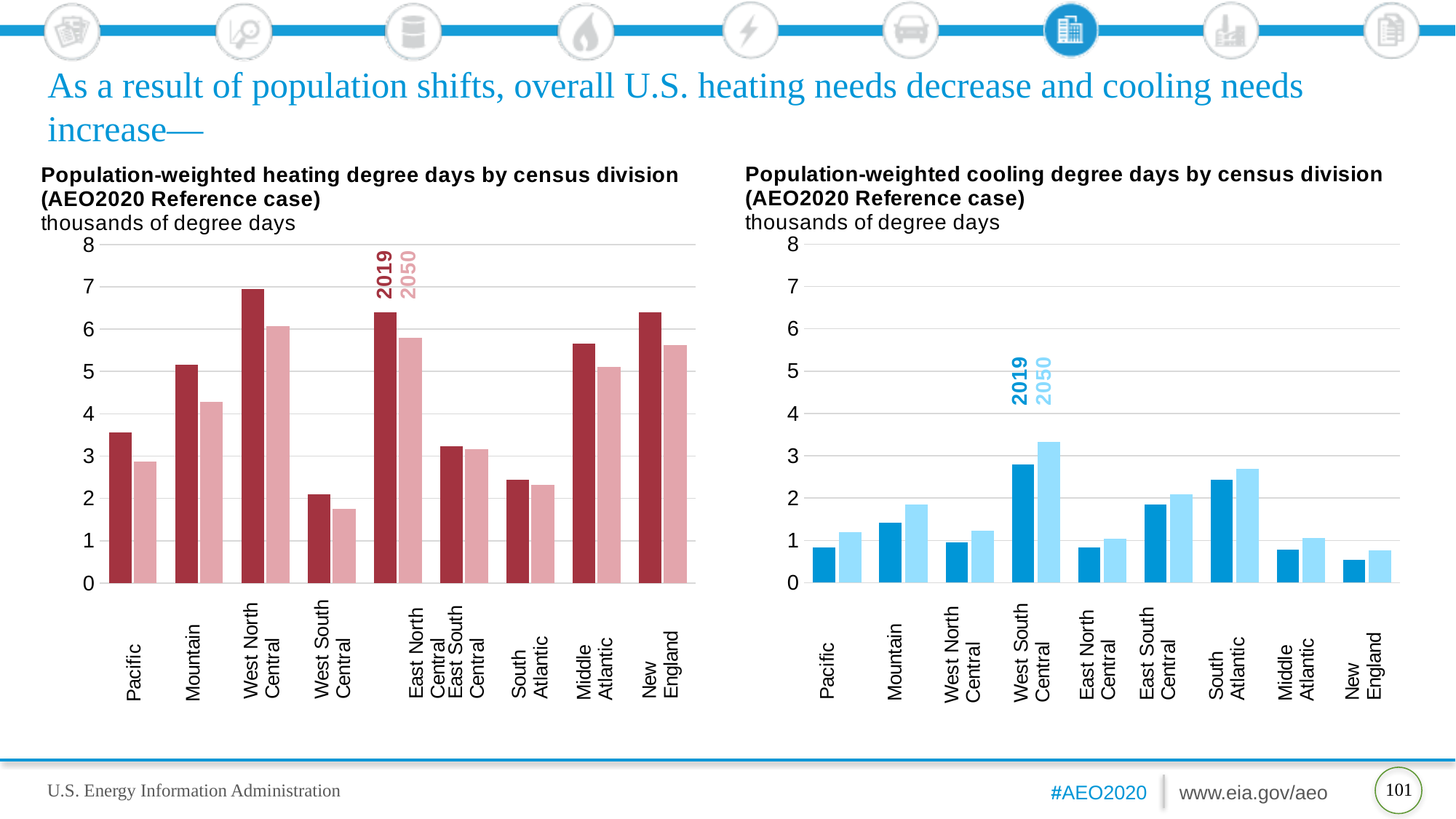
In the heating degree days chart, which census division has the highest value for 2019? West North Central In the heating degree days chart, which is larger for Mountain: the 2019 value or the 2050 value? 2019 In the heating degree days chart, which census division has the lowest value for 2019? West South Central In the cooling degree days chart, which census division has the lowest value for 2019? New England In the cooling degree days chart, which is larger for South Atlantic: the 2019 value or the 2050 value? 2050 How many series does the legend of the heating degree days chart list? 2 In the cooling degree days chart, which census division has the highest value for 2050? West South Central In the heating degree days chart, is the 2019 value for West North Central greater or less than 6? greater In the cooling degree days chart, is the 2050 value for West South Central greater or less than 3? greater What kind of chart is the cooling degree days chart? Bar chart How many census divisions are shown on the x axis of the cooling degree days chart? 9 In the heating degree days chart, is the 2050 value for Pacific greater or less than 3? less